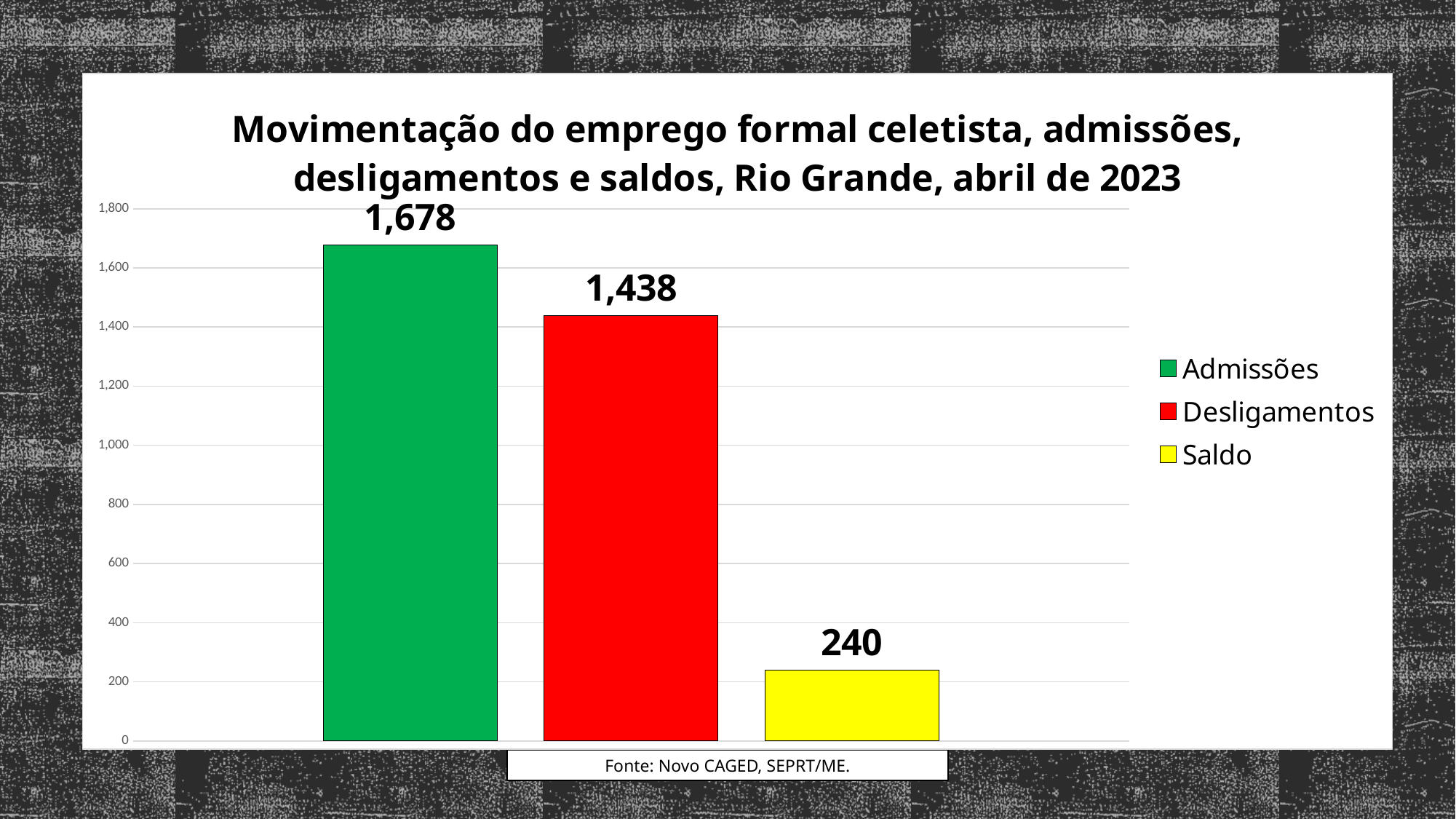
What kind of chart is shown? bar chart What colour is the bar for Saldo? yellow What source is cited below the chart? Fonte: Novo CAGED, SEPRT/ME. Which is larger, Desligamentos or Saldo? Desligamentos What is the value for Desligamentos? 1,438 Which series has the lowest value? Saldo What is the value for Admissões? 1,678 Which series has the highest value? Admissões What is the difference between Admissões and Desligamentos? 240 What is the value for Saldo? 240 How many series does the legend list? 3 Is the value for Desligamentos greater or less than 1,400? greater